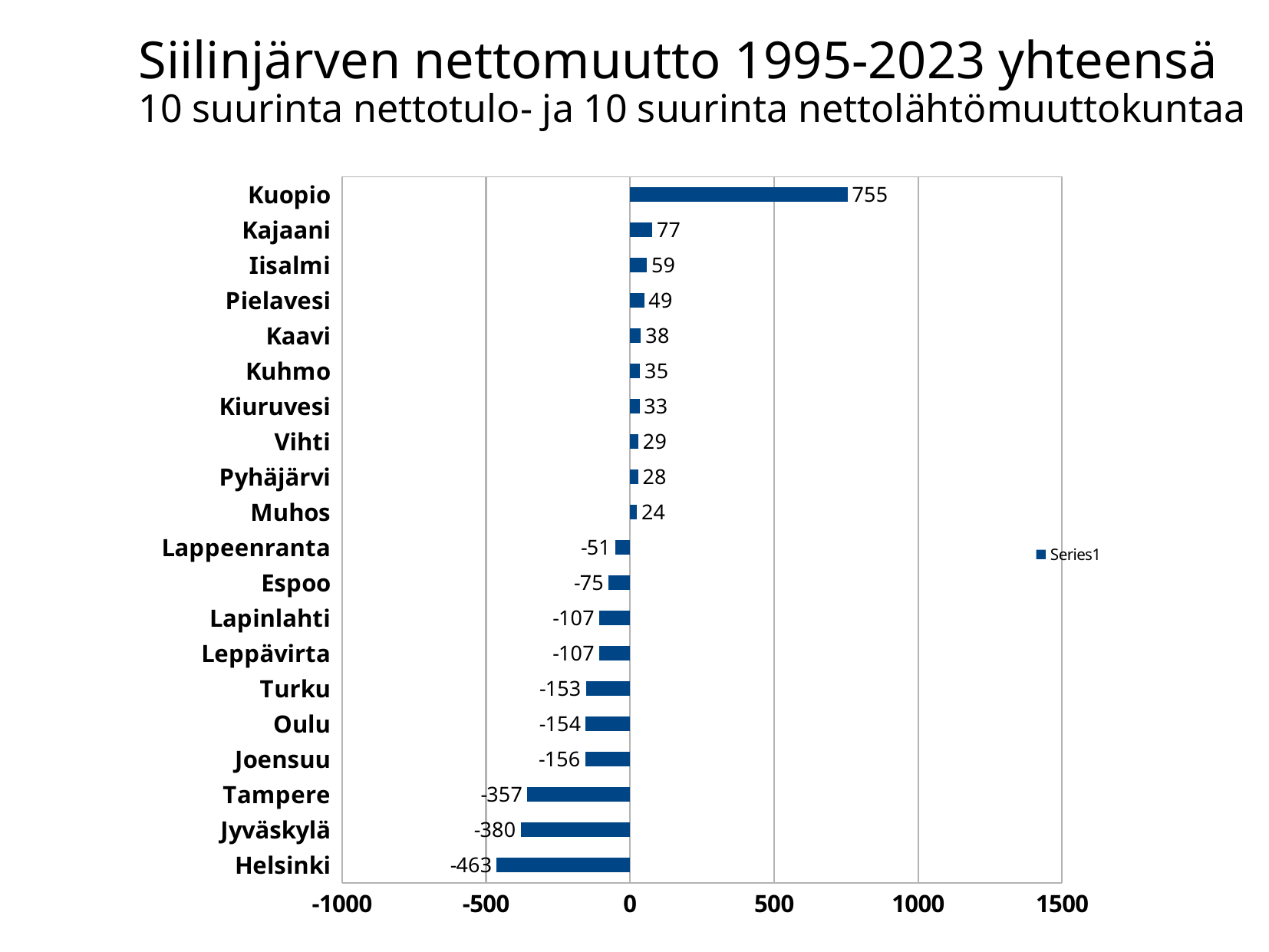
What is the value for Kajaani? 77 How many categories are shown on the chart? 20 What is the value for Tampere? -357 What is the value for Kuopio? 755 Which category has the highest value? Kuopio What kind of chart is shown on the slide? Bar chart What is the difference between the values for Kuopio and Kajaani? 678 What is the value for Helsinki? -463 What is the difference between the values for Jyväskylä and Helsinki? 83 Which has a larger value, Iisalmi or Pielavesi? Iisalmi What is the title of the chart? Siilinjärven nettomuutto 1995-2023 yhteensä Which category has the lowest value? Helsinki